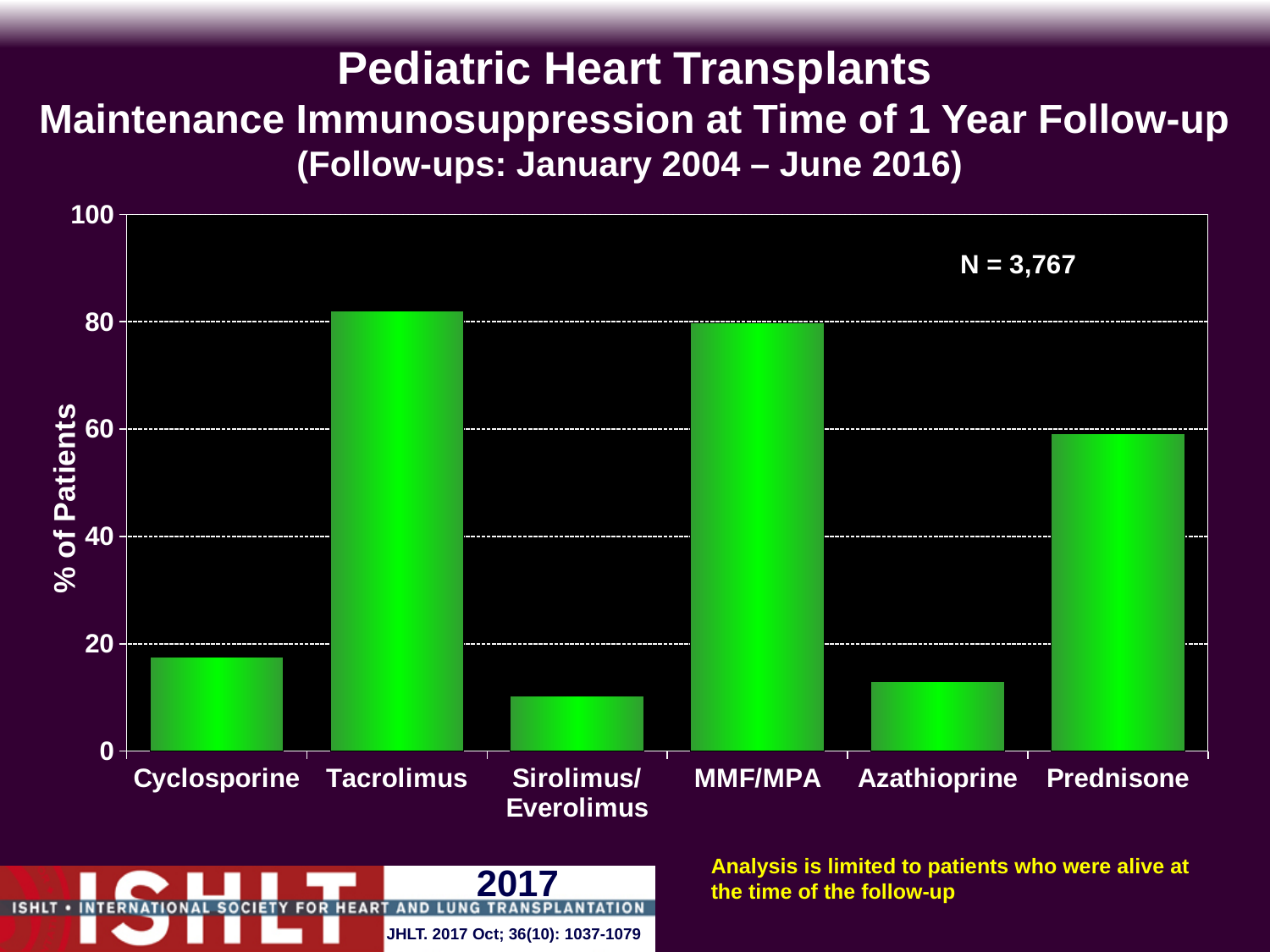
Is the value for Prednisone greater or less than 40? greater Is the value for Azathioprine greater or less than 20? less Is the value for Tacrolimus greater or less than 60? greater Which is larger, the value for Tacrolimus or the value for Azathioprine? Tacrolimus What is the N value shown on the chart? N = 3,767 How many immunosuppression categories are shown on the x axis? 6 What is the label of the y axis? % of Patients Which is larger, the value for Prednisone or the value for Cyclosporine? Prednisone What kind of chart is shown on the slide? bar chart